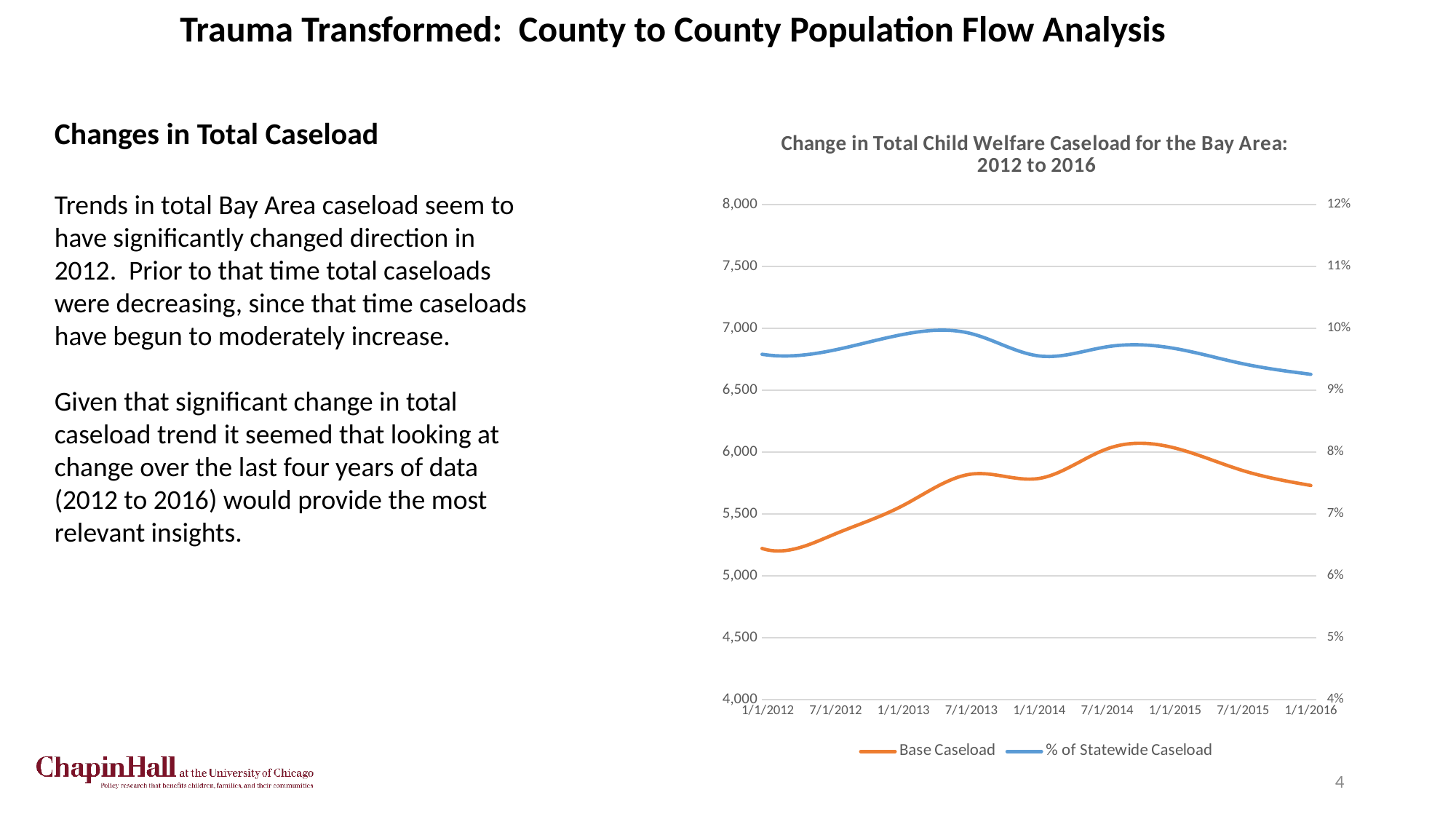
Does the % of Statewide Caseload line rise or fall between 7/1/2014 and 1/1/2016? fall Is the Base Caseload value at 1/1/2012 greater or less than 5,500? less How many date labels are shown on the x axis? 9 Does the Base Caseload line rise or fall between 1/1/2012 and 7/1/2013? rise How many series does the chart legend list? 2 Is the % of Statewide Caseload value at 1/1/2016 greater or less than 10%? less What kind of chart is shown on the slide? line chart Is the % of Statewide Caseload value at 1/1/2012 greater or less than 9%? greater Which colour is used for the Base Caseload line? orange What is the title of the chart? Change in Total Child Welfare Caseload for the Bay Area: 2012 to 2016